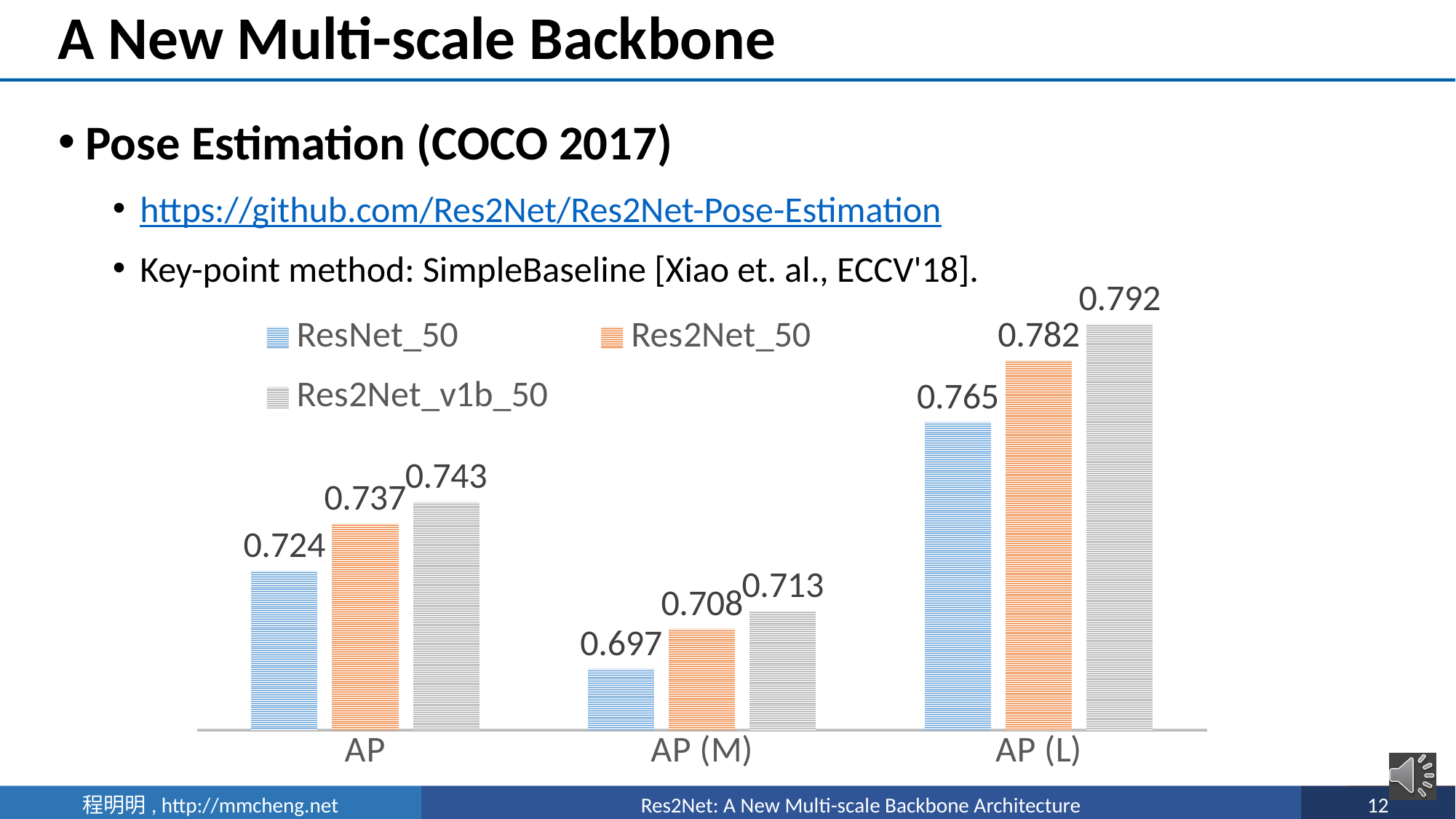
What is the AP (L) value for Res2Net_v1b_50? 0.792 Which series has the lowest AP (M) value? ResNet_50 What is the difference between the AP (L) values of Res2Net_50 and ResNet_50? 0.017 Which series has the highest AP (L) value? Res2Net_v1b_50 What kind of chart is shown on the slide? Bar chart What is the AP value for ResNet_50? 0.724 What is the difference between the AP values of Res2Net_v1b_50 and ResNet_50? 0.019 Which is larger: the AP (M) value for Res2Net_v1b_50 or the AP value for ResNet_50? AP value for ResNet_50 Which series is shown in orange in the legend? Res2Net_50 How many categories are shown on the x axis? 3 What is the AP (M) value for Res2Net_50? 0.708 How many series does the legend list? 3